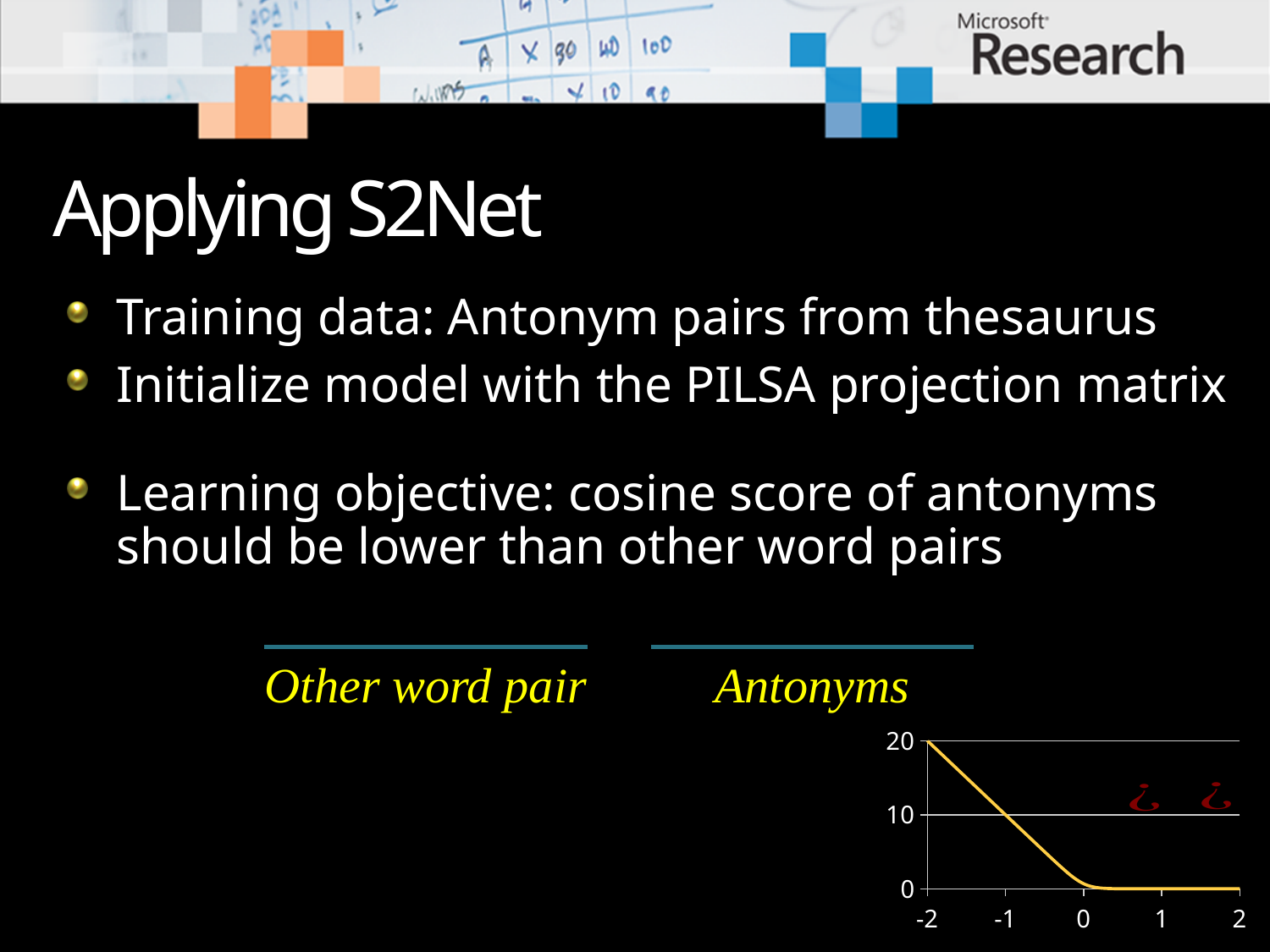
In the chart at the bottom right, is the line value at x = -2 larger or smaller than at x = 1? larger What colour is the line in the chart at the bottom right? yellow What kind of chart is shown at the bottom right of the slide? line chart In the chart at the bottom right, is the value of the line at x = 0 greater or less than 10? less In the chart at the bottom right, do the values rise or fall as x increases from -2 to 0? fall In the chart at the bottom right, what is the value of the line at x = 1? 0 In the chart at the bottom right, is the value of the line at x = -1.5 greater or less than 10? greater In the chart at the bottom right, what is the value of the line at x = 2? 0 How many tick labels are shown on the x axis of the chart at the bottom right? 5 What is the highest value labelled on the y axis of the chart at the bottom right? 20 In the chart at the bottom right, what is the value of the line at x = -2? 20 In the chart at the bottom right, at which labelled x value is the line highest? -2